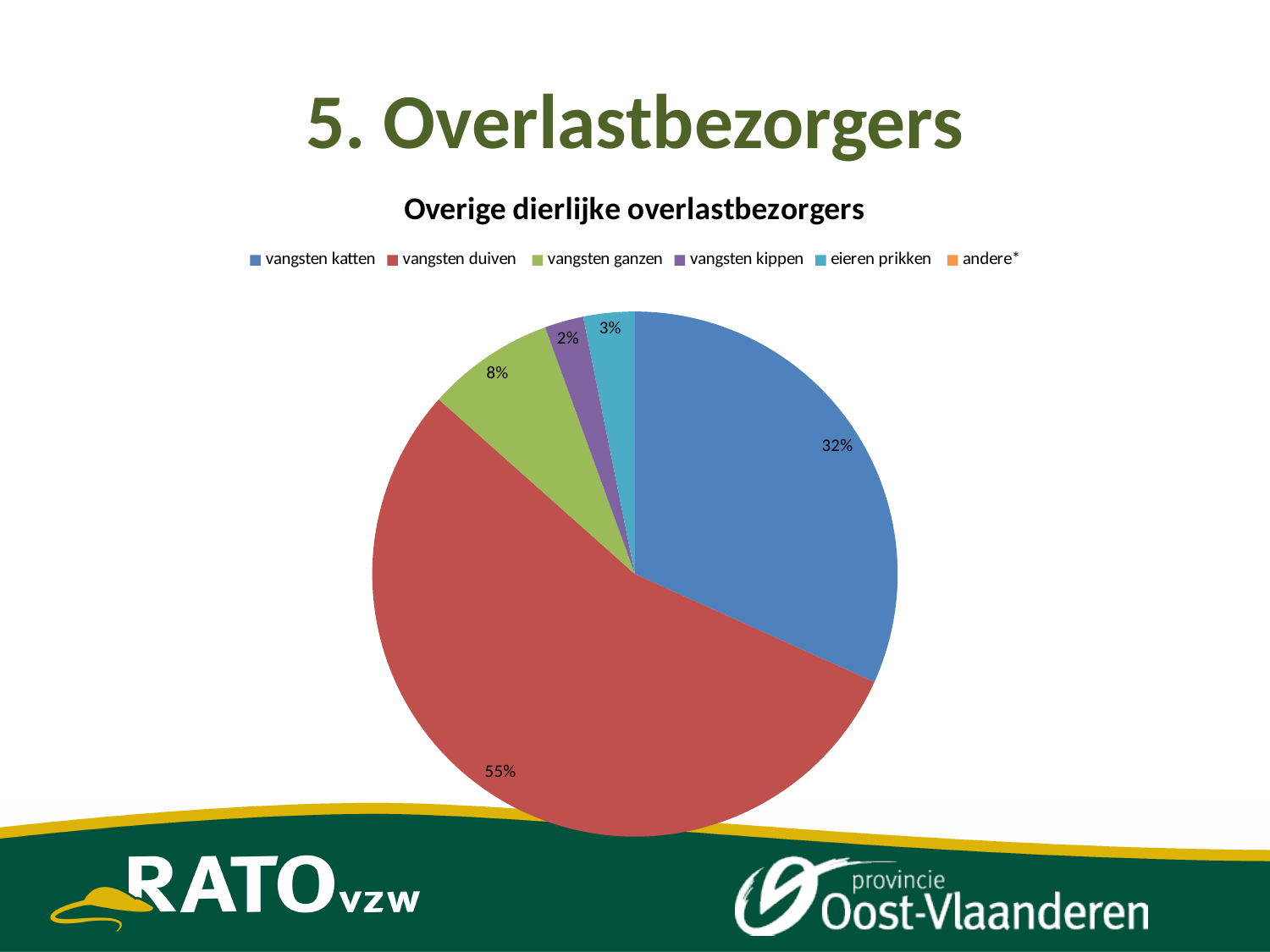
What share of the pie is 'vangsten duiven'? 55% What is the title of the chart? Overige dierlijke overlastbezorgers Which category has the largest slice of the pie? vangsten duiven What share of the pie is 'eieren prikken'? 3% What kind of chart is shown on the slide? pie chart How many entries does the chart legend list? 6 Which is larger, the share for 'vangsten ganzen' or the share for 'eieren prikken'? vangsten ganzen What share of the pie is 'vangsten katten'? 32% Which labelled slice is the smallest? vangsten kippen What is the difference between the shares of 'vangsten duiven' and 'vangsten katten'? 23%